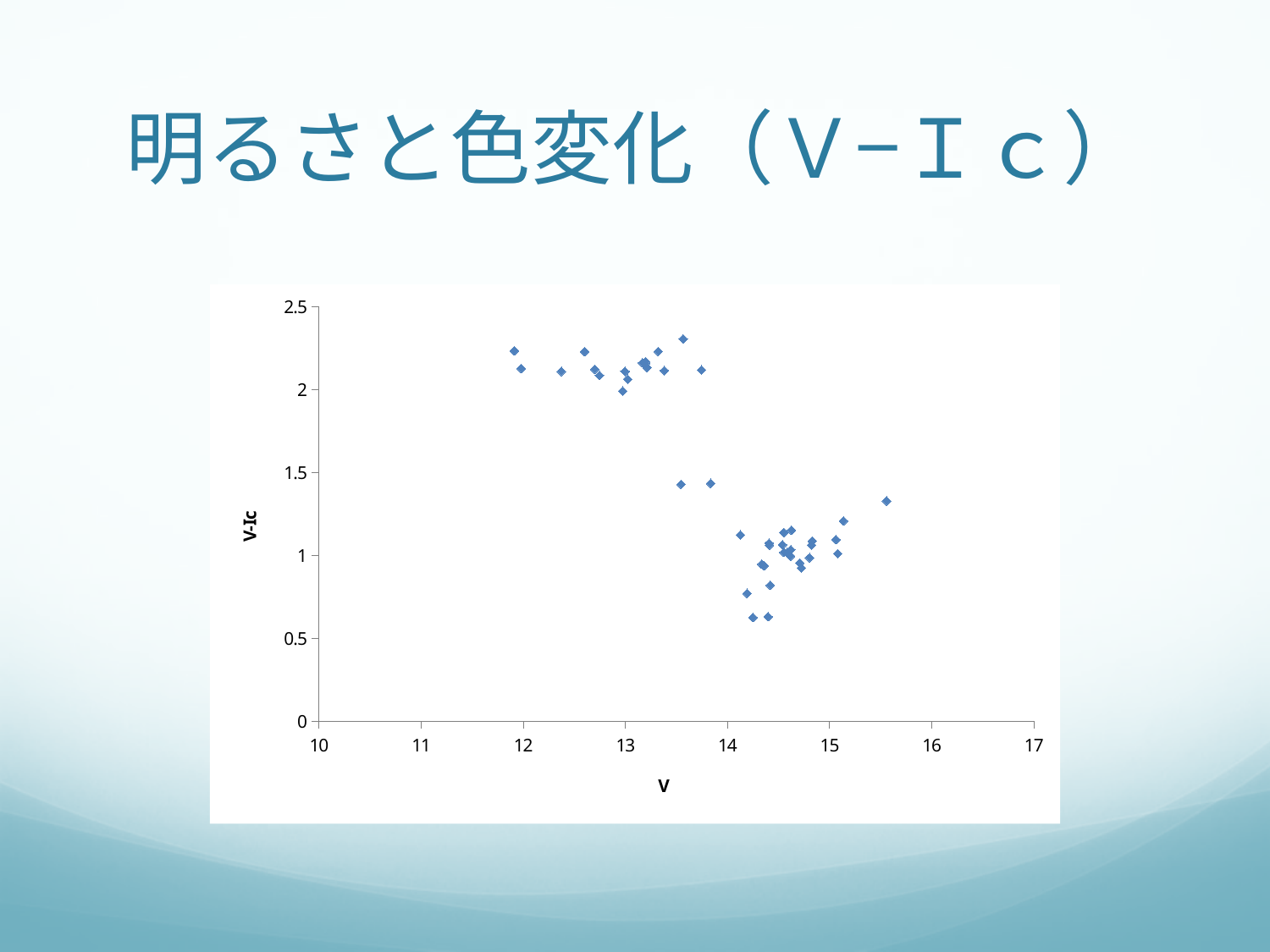
Is the V-Ic value of the point near V = 12 greater or less than 2? greater Is the V-Ic value of the point near V = 13.5 at the top of the cluster greater or less than 2.5? less Is the V-Ic value of the point near V = 15.5 greater or less than 1.5? less Which group of points has higher V-Ic values: those near V = 13 or those near V = 14.5? those near V = 13 What kind of chart is shown on the slide? scatter plot What is the label of the y axis of the chart? V-Ic As V increases along the x axis, do the V-Ic values generally rise or fall? fall What is the label of the x axis of the chart? V